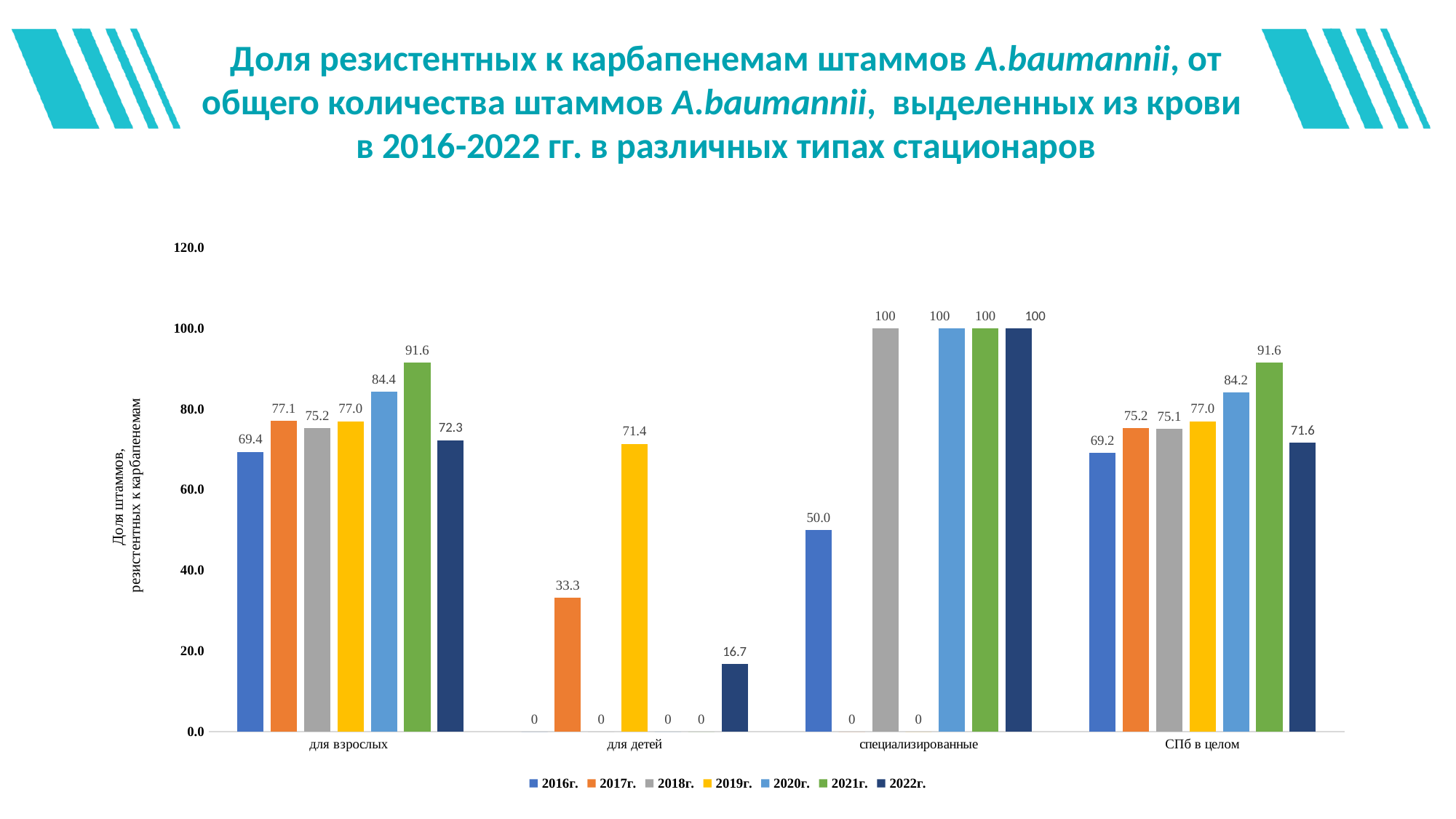
What type of chart is shown on the slide? bar chart Which year has the highest value in the category "для взрослых"? 2021г. What is the value for 2022г. in the category "СПб в целом"? 71.6 How many series does the legend list? 7 Which year has the lowest non-zero value in the category "для детей"? 2022г. What is the difference between the 2020г. and 2016г. values in the category "СПб в целом"? 15.0 Which is larger in the category "для взрослых": the value for 2017г. or the value for 2022г.? 2017г. What is the value for 2016г. in the category "специализированные"? 50.0 What is the value for 2017г. in the category "для детей"? 33.3 What is the label of the y axis? Доля штаммов, резистентных к карбапенемам What is the value for 2021г. in the category "для взрослых"? 91.6 How many categories are shown on the x axis? 4